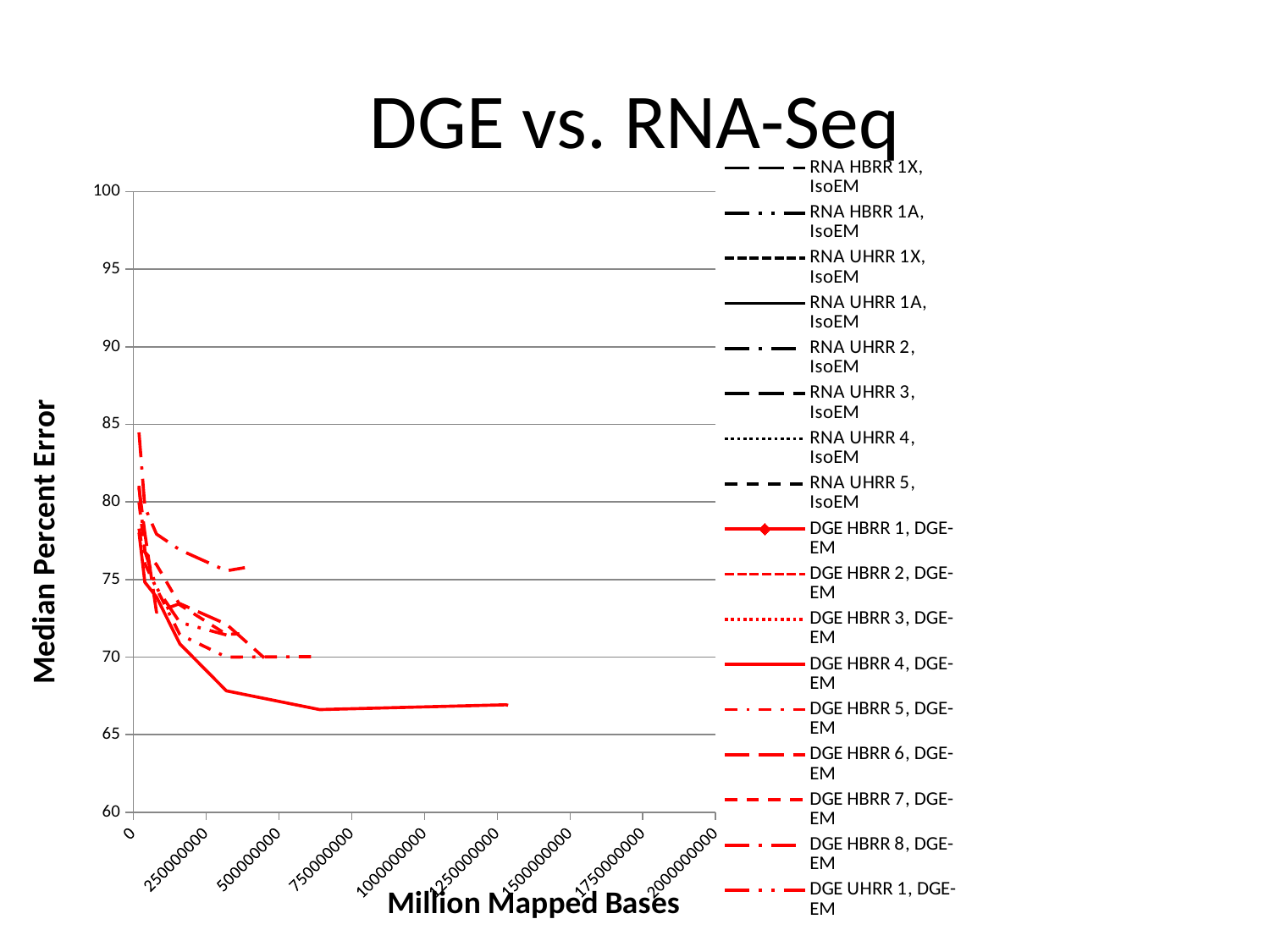
What is the label of the vertical axis? Median Percent Error Do the plotted median percent error values rise or fall as the number of mapped bases increases? fall What is the maximum value shown on the vertical axis? 100 Is the final value of the lowest plotted line (the solid red DGE HBRR 4, DGE-EM series) greater or less than 70? less How many series does the legend list? 17 What kind of chart is shown on the slide? line chart Is the highest plotted value on the chart, at the far left, greater or less than 80? greater Which series extends furthest to the right along the x axis? DGE HBRR 4, DGE-EM What is the title of the chart? DGE vs. RNA-Seq Is the final value of the solid red DGE HBRR 4, DGE-EM line greater or less than 65? greater